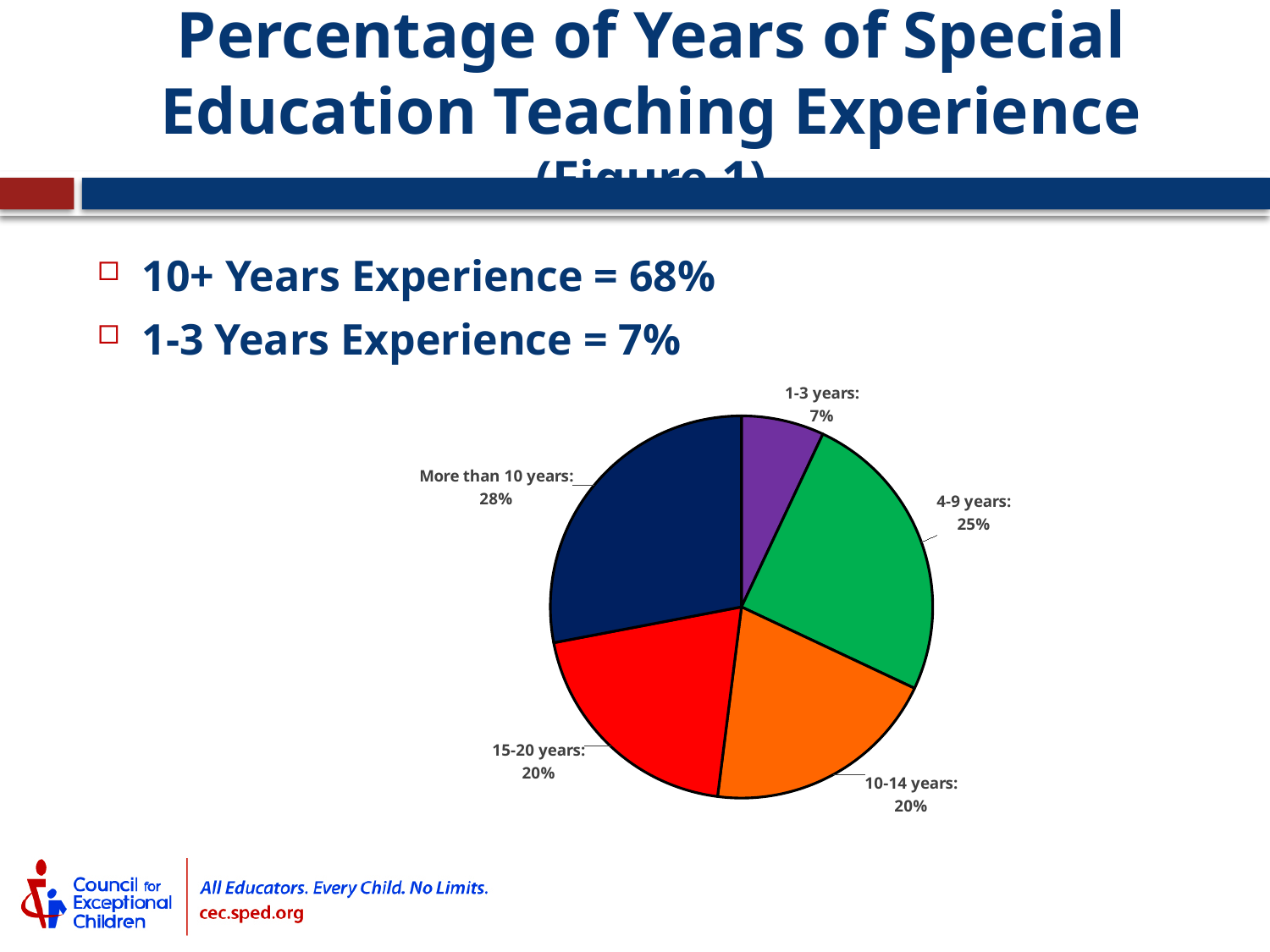
What is the combined percentage of the 10-14 years and 15-20 years slices? 40% What percentage of the pie chart is for More than 10 years? 28% What percentage of the pie chart is for 15-20 years? 20% What is the difference in percentage points between the More than 10 years slice and the 1-3 years slice? 21 Which slice is larger, 4-9 years or 10-14 years? 4-9 years What percentage of the pie chart is for 1-3 years? 7% Which category has the smallest slice of the pie chart? 1-3 years Which category has the largest slice of the pie chart? More than 10 years What percentage of the pie chart is for 4-9 years? 25% What type of chart is shown on the slide? Pie chart What colour is the 4-9 years slice of the pie chart? Green How many slices does the pie chart have? 5